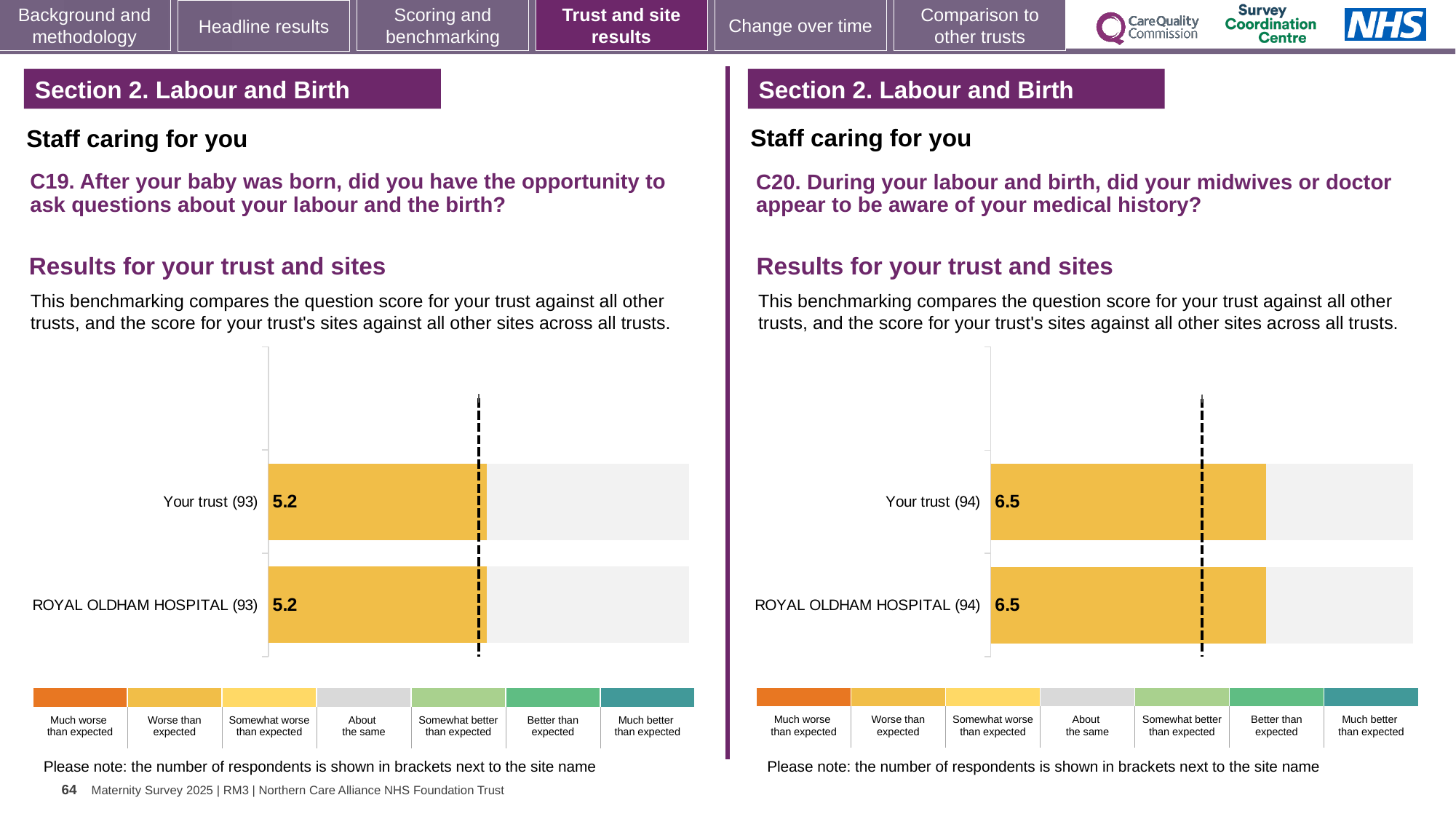
How many bars are plotted on the right chart (C20)? 2 On the right chart (C20), what is the score for Your trust? 6.5 How many categories does the colour legend below the right chart (C20) list? 7 On the right chart (C20), what is the difference between the score for Your trust and the score for ROYAL OLDHAM HOSPITAL? 0 On the left chart (C19), what is the score for ROYAL OLDHAM HOSPITAL? 5.2 How many bars are plotted on the left chart (C19)? 2 On the right chart (C20), what is the score for ROYAL OLDHAM HOSPITAL? 6.5 On the right chart (C20), how many respondents are shown in brackets next to ROYAL OLDHAM HOSPITAL? 94 What kind of chart is used on the left (C19) to show the results for your trust and sites? Bar chart On the left chart (C19), how many respondents are shown in brackets next to Your trust? 93 On the left chart (C19), what is the difference between the score for Your trust and the score for ROYAL OLDHAM HOSPITAL? 0 On the left chart (C19), what is the score for Your trust? 5.2